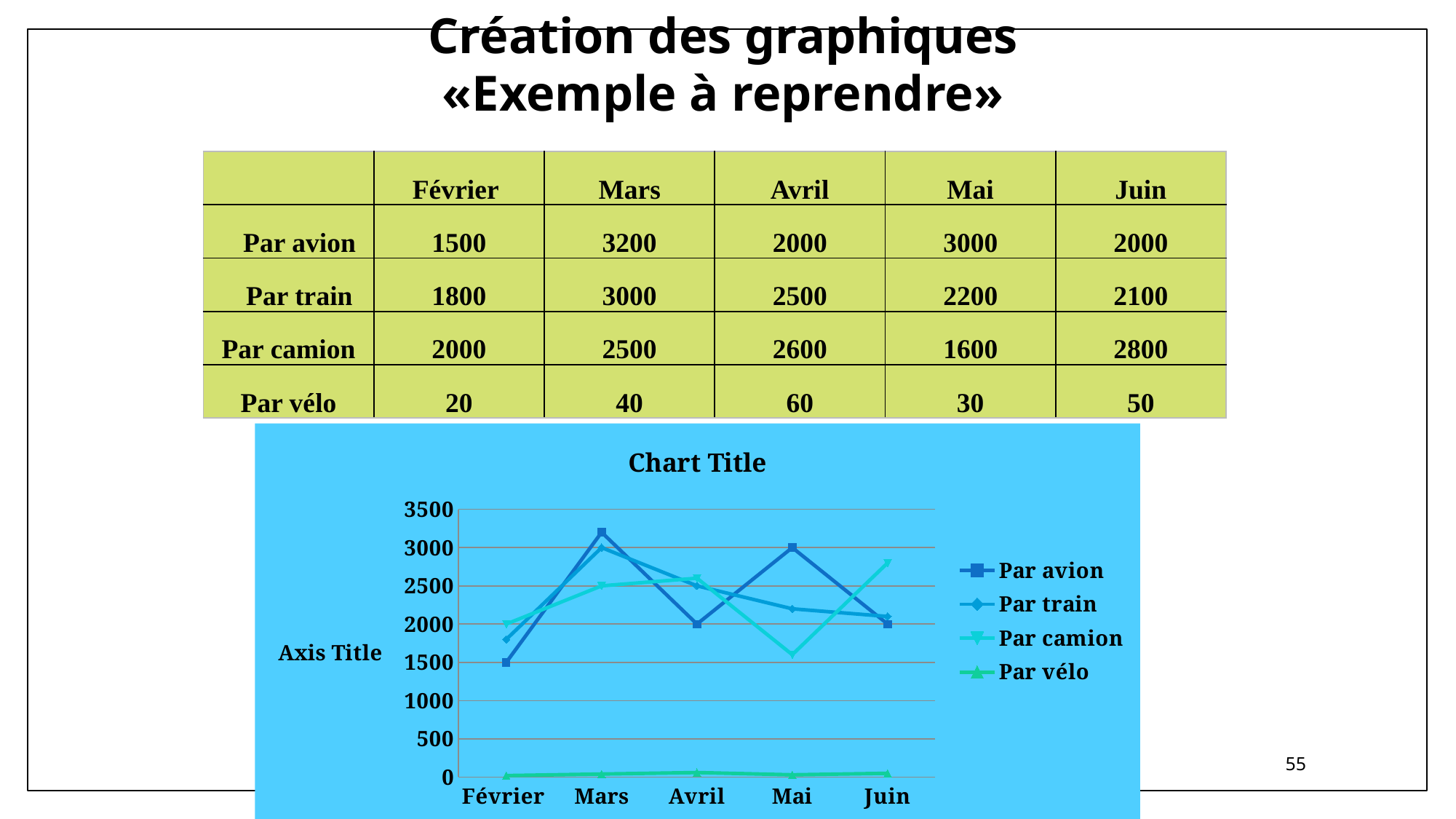
What type of chart is shown on the slide? line chart What is the title shown above the chart? Chart Title Is the value for Par avion in Mai greater or less than 2500? greater What is the value for Par avion in Mars? 3200 Does the Par train series rise or fall from Mars to Juin? fall What is the difference between Par train in Mars and Par train in Juin? 900 In which month is the value for Par avion highest? Mars In which month is the value for Par camion lowest? Mai How many months are shown on the x axis of the chart? 5 Which is larger in Avril, Par camion or Par avion? Par camion How many series does the chart legend list? 4 What is the value for Par camion in Mai? 1600